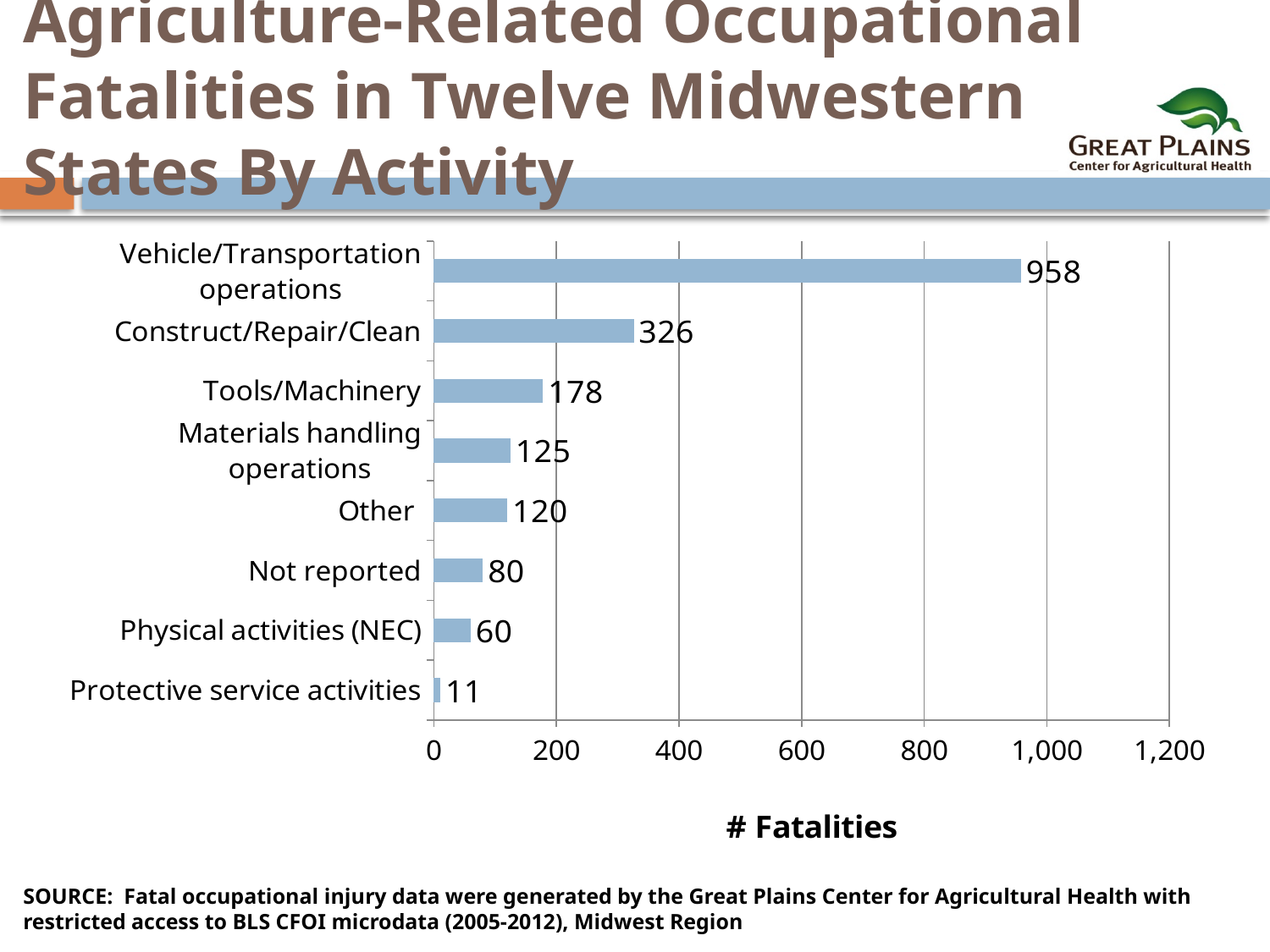
What kind of chart is shown on the slide? bar chart What is the label of the horizontal axis? # Fatalities Which activity has the highest number of fatalities? Vehicle/Transportation operations Which has more fatalities, Other or Physical activities (NEC)? Other Which activity has the lowest number of fatalities? Protective service activities What is the difference in fatalities between Vehicle/Transportation operations and Construct/Repair/Clean? 632 What is the value for Construct/Repair/Clean? 326 How many fatalities are shown for Not reported? 80 How many fatalities are shown for Vehicle/Transportation operations? 958 What is the difference in fatalities between Tools/Machinery and Materials handling operations? 53 How many activity categories are shown in the chart? 8 Is the value for Construct/Repair/Clean greater or less than 400? less